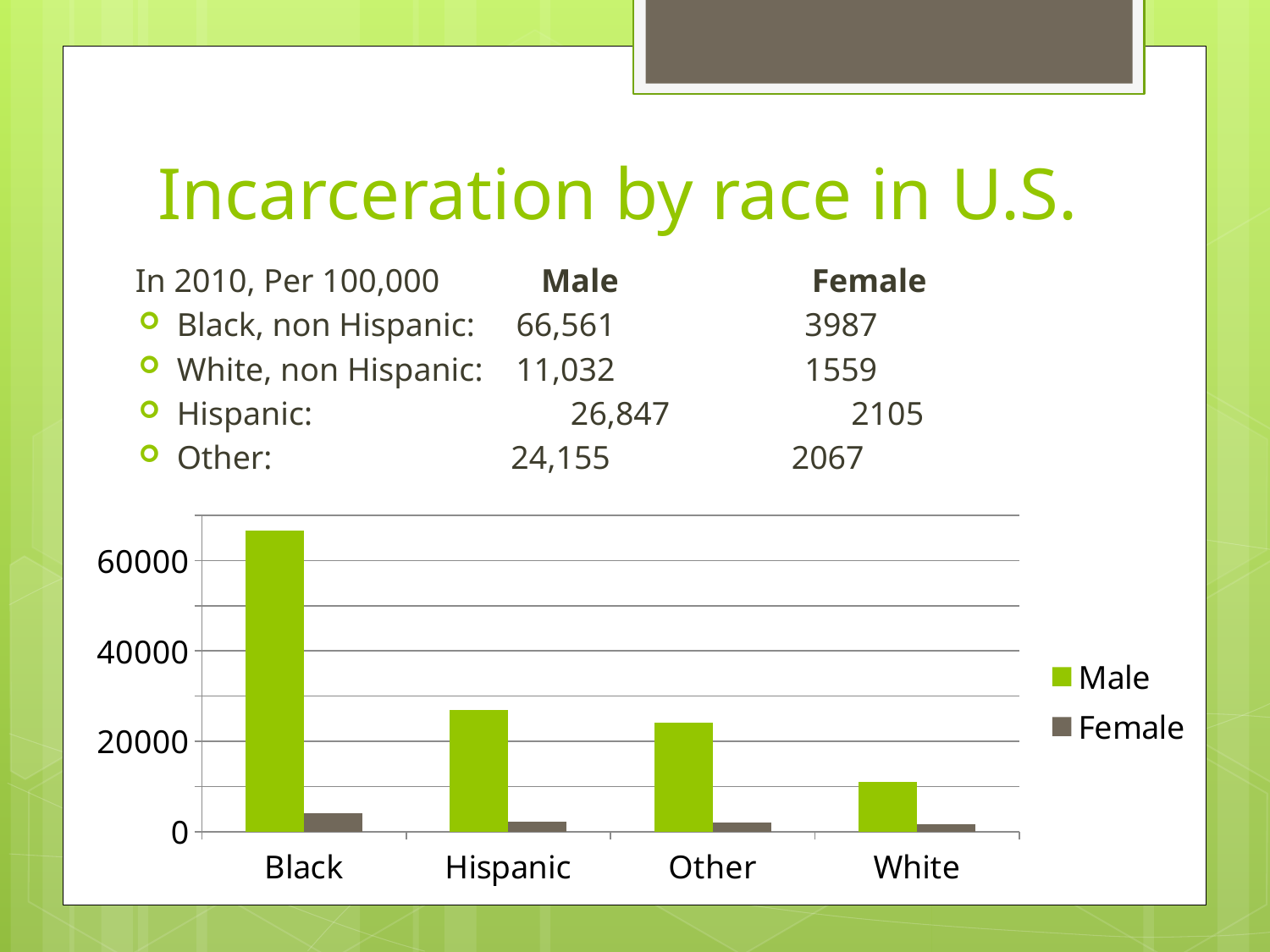
Which is larger, the Female value for Black or the Male value for White? Male value for White What kind of chart is shown on the slide? bar chart Which category has the lowest Male value in the chart? White Which category has the highest Male value in the chart? Black Is the Male value for Black greater or less than 60000? greater Is the Male value for Hispanic greater or less than 40000? less Is the Male value for White greater or less than 20000? less Which series is shown in green in the chart? Male What is the Male value for Black, non Hispanic, as printed on the slide? 66,561 How many categories are shown on the x axis of the chart? 4 Which is larger, the Male value for Hispanic or the Male value for Other? Hispanic How many series does the chart legend list? 2